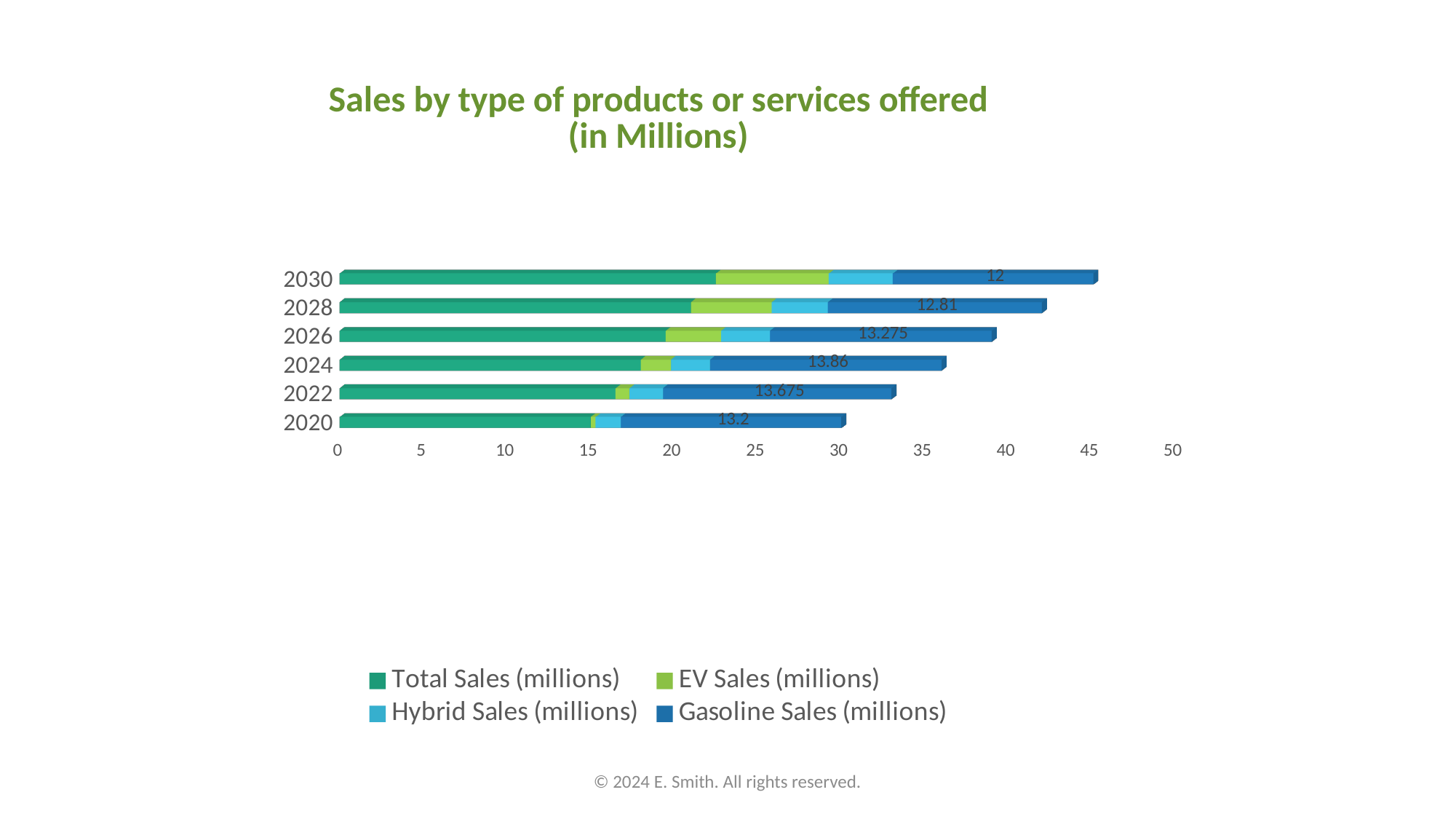
What is the Gasoline Sales (millions) value for 2024? 13.86 What is the difference between the Gasoline Sales (millions) values for 2024 and 2030? 1.86 What kind of chart is shown on the slide? Stacked bar chart How many series does the legend list? 4 Which year has the larger Gasoline Sales (millions) value, 2022 or 2026? 2022 What is the Gasoline Sales (millions) value for 2020? 13.2 Which year has the lowest Gasoline Sales (millions) value? 2030 How many years are shown on the chart? 6 Is the total length of the stacked bar for 2022 greater or less than 35? less Which year has the highest Gasoline Sales (millions) value? 2024 Is the total length of the stacked bar for 2028 greater or less than 40? greater What is the Gasoline Sales (millions) value for 2030? 12